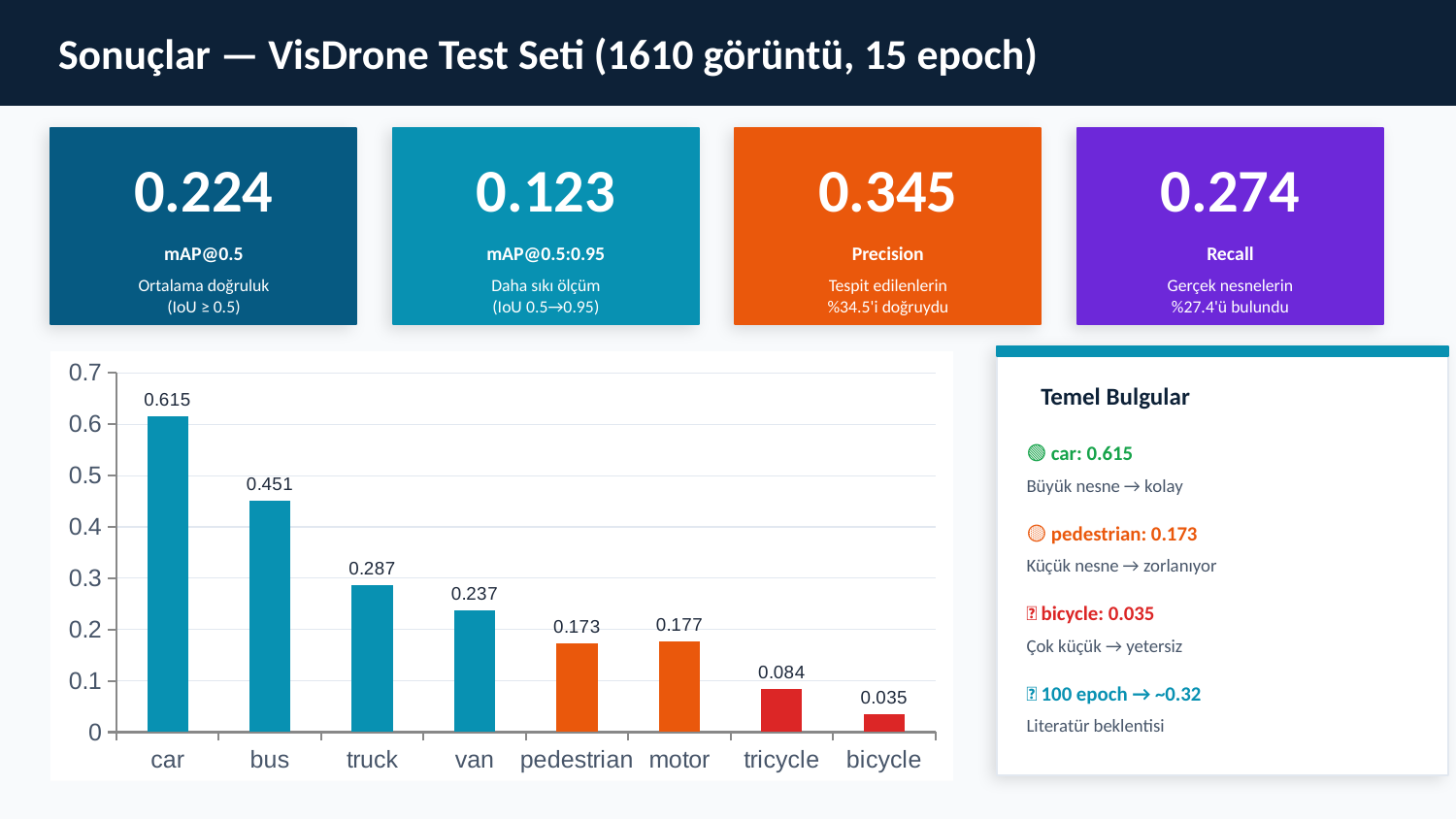
What is the difference between the values for car and bus in the bar chart? 0.164 What colour are the bars for tricycle and bicycle in the bar chart? red Which category has the highest value in the bar chart? car What is the value for car in the bar chart? 0.615 What is the value for pedestrian in the bar chart? 0.173 How many categories are shown on the x axis of the bar chart? 8 Is the value for bus in the bar chart greater or less than 0.4? greater What is the difference between the values for truck and van in the bar chart? 0.050 What kind of chart is shown on the slide? bar chart What is the value for tricycle in the bar chart? 0.084 Which category has the lowest value in the bar chart? bicycle Which is larger in the bar chart, the value for pedestrian or the value for motor? motor